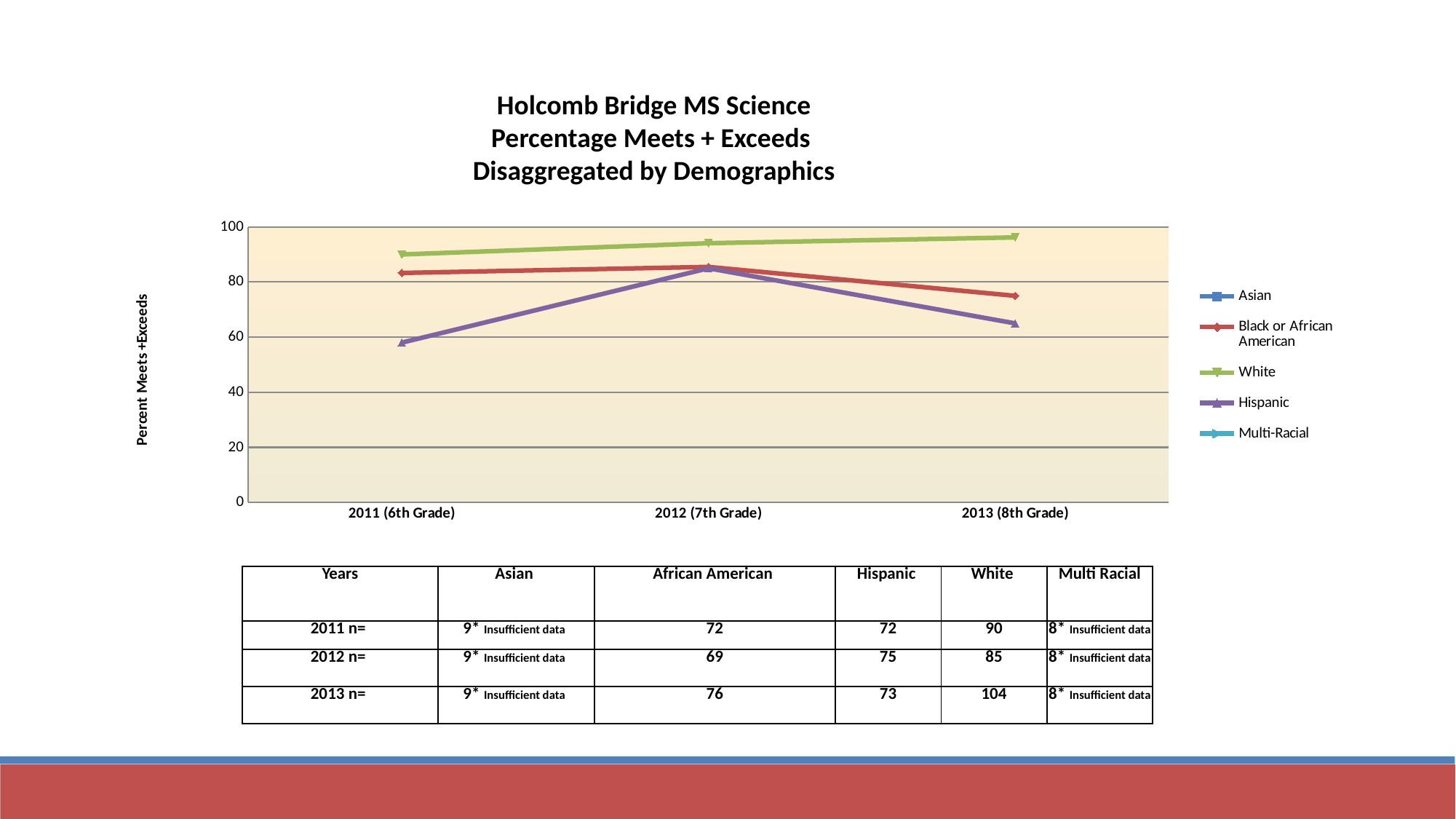
Which plotted series has the lowest value in 2013 (8th Grade)? Hispanic What is the title of the y axis? Percent Meets +Exceeds Does the White series rise or fall from 2011 (6th Grade) to 2013 (8th Grade)? rises Which series has the highest value in 2011 (6th Grade)? White Which plotted series has the lowest value in 2011 (6th Grade)? Hispanic How many series does the legend list? 5 Does the Black or African American series rise or fall from 2012 (7th Grade) to 2013 (8th Grade)? falls What kind of chart is shown on the slide? line chart Is the value for White in 2013 (8th Grade) greater or less than 80? greater Is the value for Hispanic in 2011 (6th Grade) greater or less than 80? less How many points are shown along the x axis? 3 In 2013 (8th Grade), which is larger: Black or African American or Hispanic? Black or African American